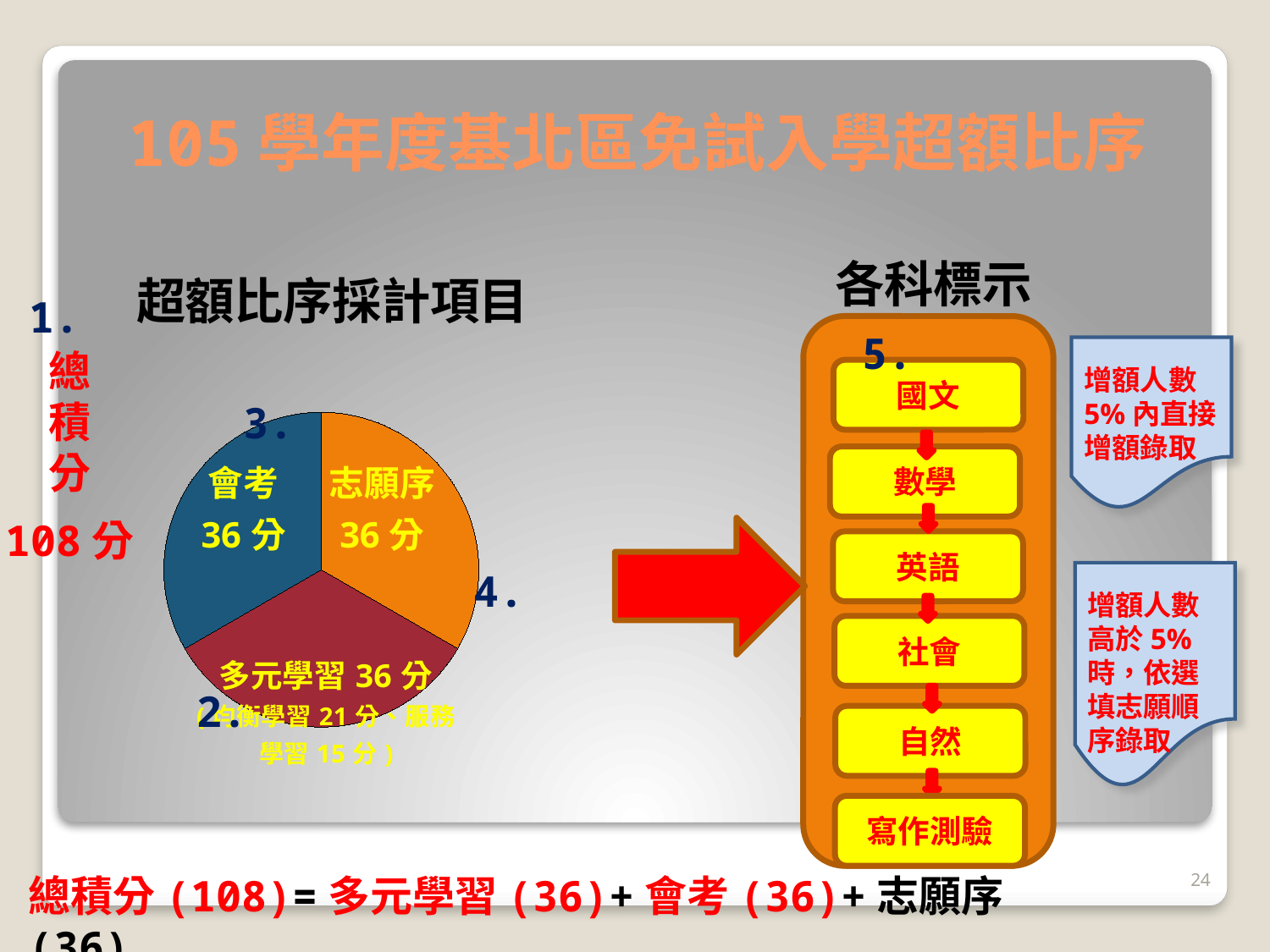
What fraction of the pie chart does the 志願序 slice represent? one third Is the value for 會考 larger than, smaller than, or equal to the value for 志願序 in the pie chart? equal How many slices does the pie chart have? 3 According to the pie chart label, how many points does 均衡學習 contribute within 多元學習? 21 分 What is the value shown for 多元學習 in the pie chart? 36 分 What is the total of the three slices in the pie chart? 108 分 What is the value shown for 志願序 in the pie chart? 36 分 What colour is the 會考 slice in the pie chart? blue What is the value shown for 會考 in the pie chart? 36 分 What is the difference between the values for 會考 and 志願序 in the pie chart? 0 分 According to the pie chart label, how many points does 服務學習 contribute within 多元學習? 15 分 What kind of chart is shown under the heading 超額比序採計項目? pie chart